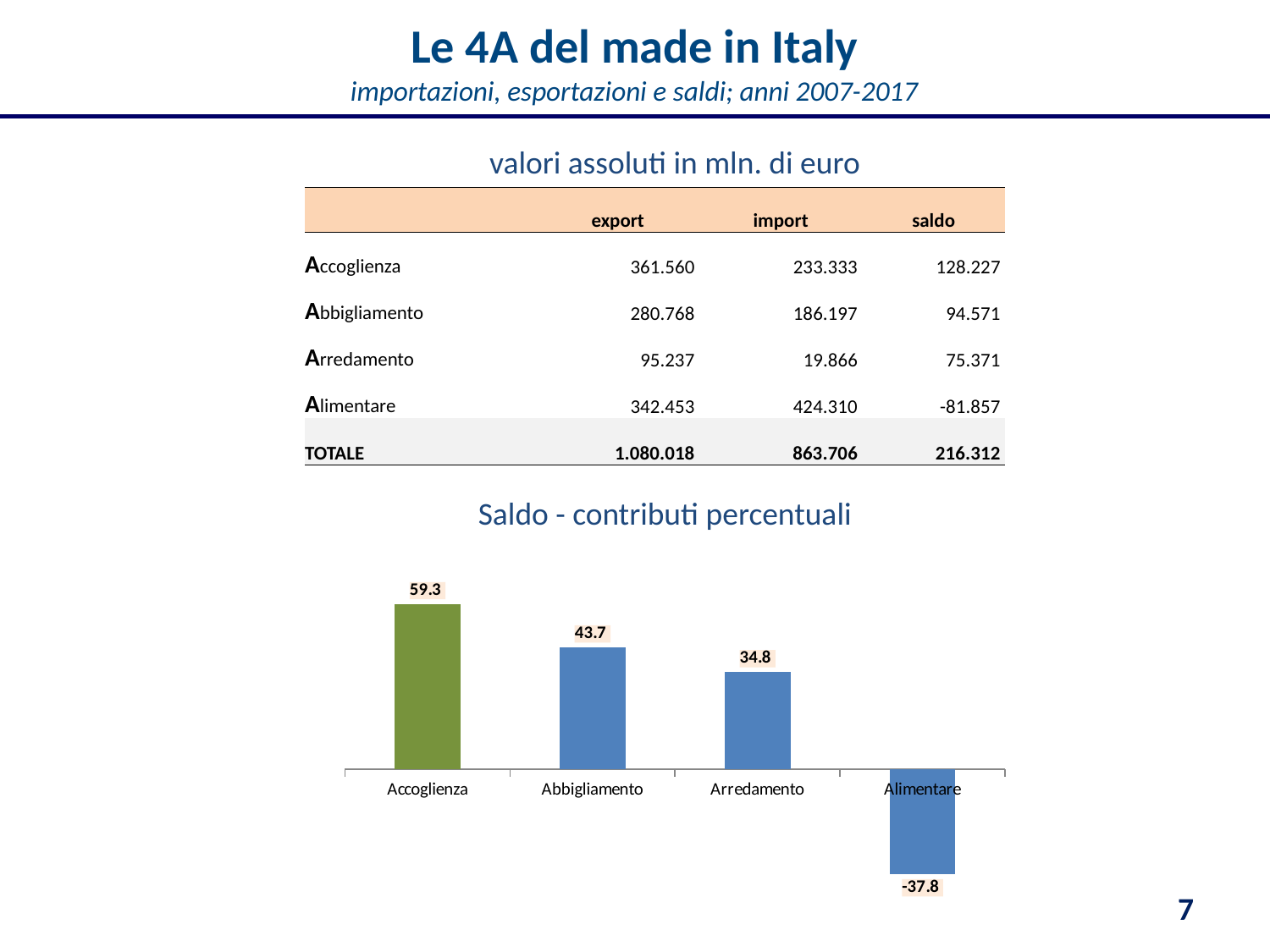
How many categories are shown in the chart 'Saldo - contributi percentuali'? 4 In the chart 'Saldo - contributi percentuali', what is the value for Accoglienza? 59.3 In the chart 'Saldo - contributi percentuali', which category is the only one with a negative value? Alimentare In the chart 'Saldo - contributi percentuali', what is the difference between the values for Accoglienza and Abbigliamento? 15.6 In the chart 'Saldo - contributi percentuali', which bar is coloured green rather than blue? Accoglienza In the chart 'Saldo - contributi percentuali', what is the value for Abbigliamento? 43.7 In the chart 'Saldo - contributi percentuali', which is larger, the value for Abbigliamento or the value for Arredamento? Abbigliamento What kind of chart is 'Saldo - contributi percentuali'? Bar chart In the chart 'Saldo - contributi percentuali', what is the value for Alimentare? -37.8 In the chart 'Saldo - contributi percentuali', what is the value for Arredamento? 34.8 In the chart 'Saldo - contributi percentuali', which category has the lowest value? Alimentare In the chart 'Saldo - contributi percentuali', which category has the highest value? Accoglienza